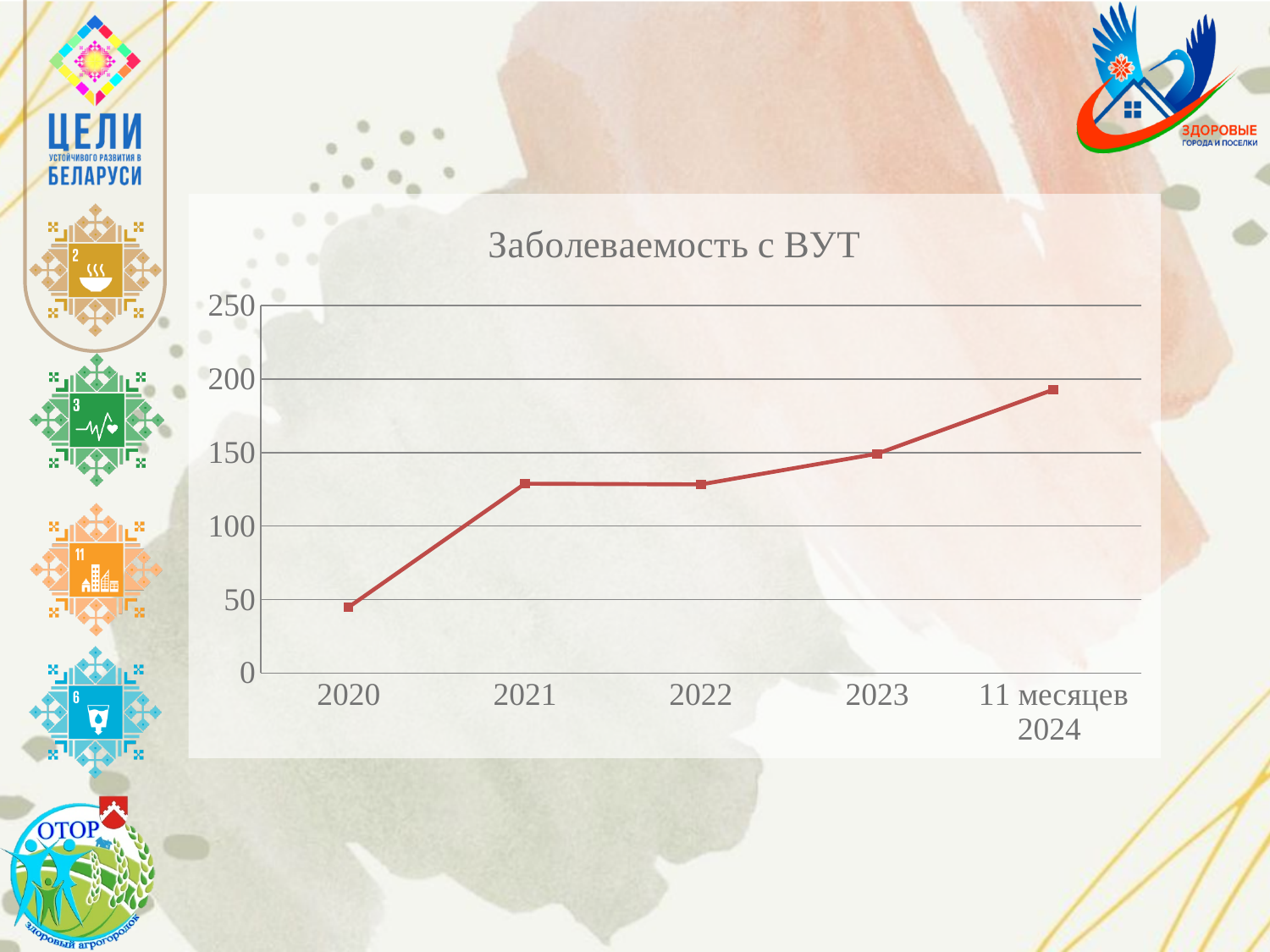
Is the value for 2020 greater or less than 50? less Is the value for 2022 greater or less than 150? less Which is larger, the value for 2022 or the value for 2023? 2023 How many points are plotted along the x axis of the chart? 5 Which category has the highest value in the chart? 11 месяцев 2024 Which category has the lowest value in the chart? 2020 What kind of chart is shown on the slide? line chart Is the value for 2021 greater or less than 100? greater Do the values generally rise or fall from 2020 to 11 месяцев 2024? rise What is the title of the chart? Заболеваемость с ВУТ Which is larger, the value for 2020 or the value for 2021? 2021